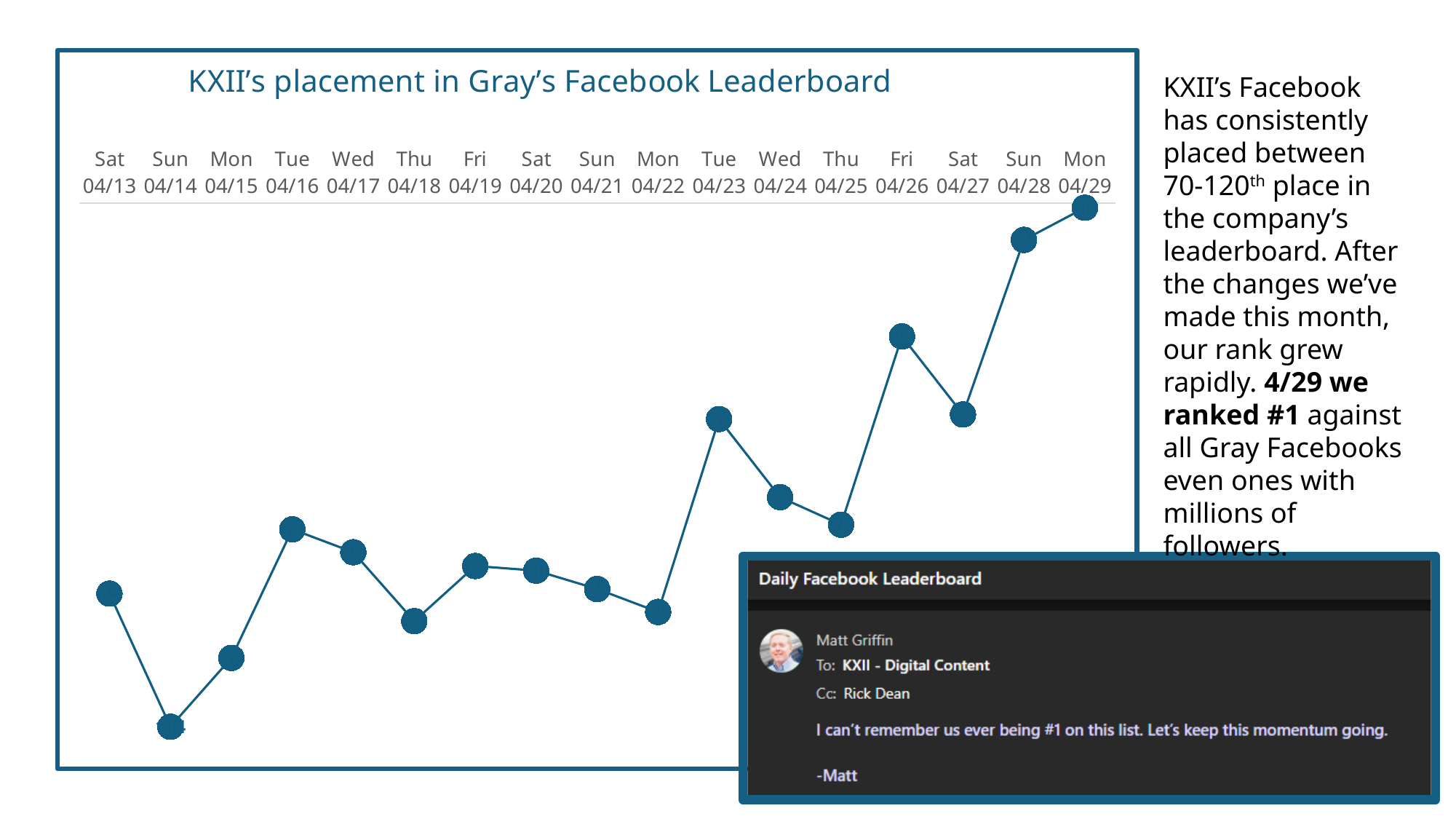
What is the first date shown on the x axis of the chart? Sat 04/13 Which point is higher on the chart, Mon 04/15 or Tue 04/16? Tue 04/16 Which date has the highest point on the chart? Mon 04/29 Which point is higher on the chart, Mon 04/22 or Tue 04/23? Tue 04/23 Which point is higher on the chart, Fri 04/26 or Sat 04/27? Fri 04/26 What kind of chart is shown on the slide? line chart Which date has the lowest point on the chart? Sun 04/14 How many dates are plotted along the x axis of the chart? 17 What is the title of the chart? KXII's placement in Gray's Facebook Leaderboard Does the line rise or fall between Sat 04/27 and Sun 04/28? rise Overall, does the line rise or fall from 04/13 to 04/29? rise